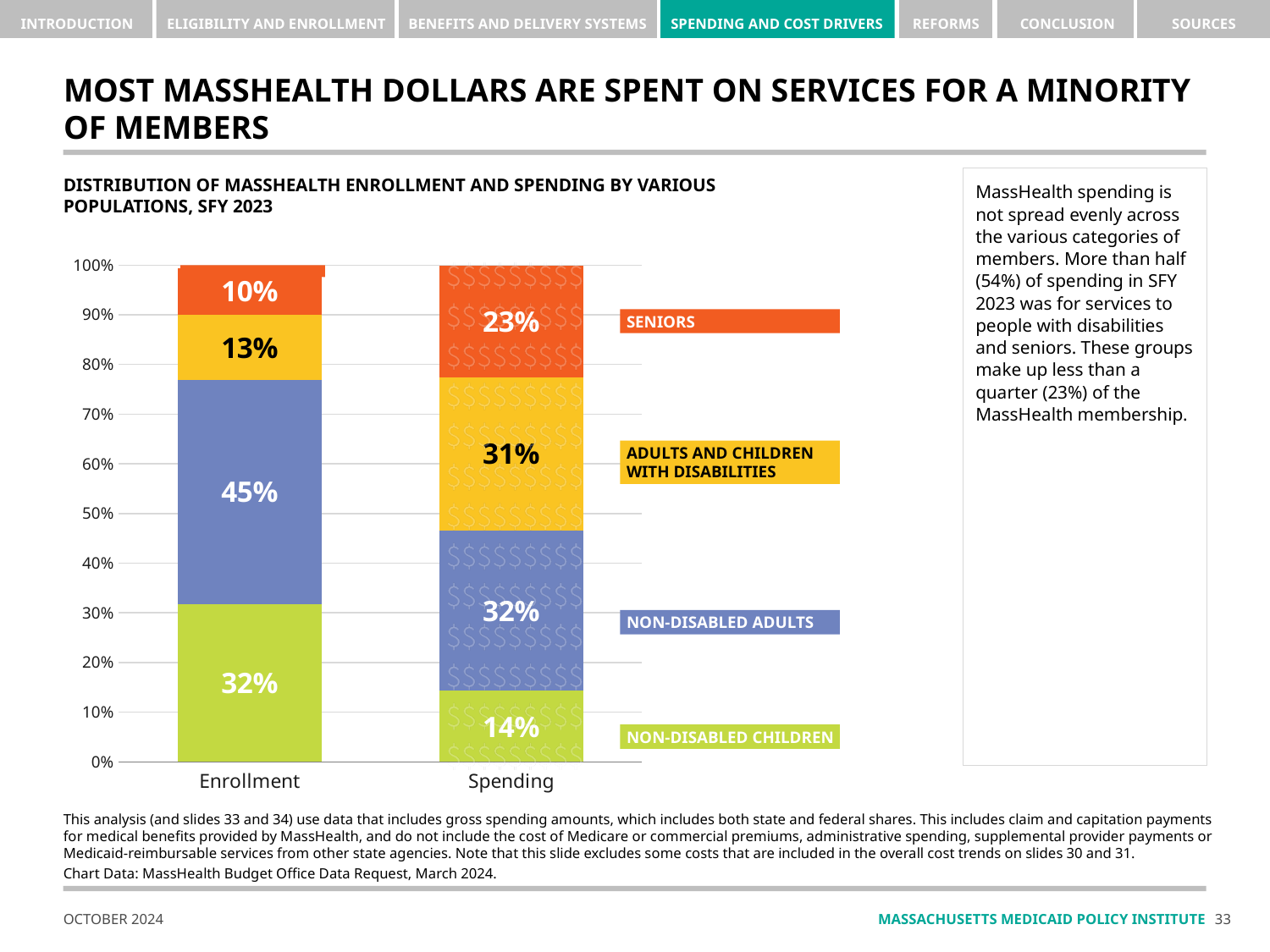
Is the Non-Disabled Children share larger in Enrollment or in Spending? Enrollment What share of Spending goes to Seniors? 23% Which population group has the smallest share of Spending? Non-Disabled Children What share of Enrollment is made up of Non-Disabled Adults? 45% What type of chart is shown on the slide? Stacked bar chart Which population group has the largest share of Enrollment? Non-Disabled Adults What share of Enrollment is made up of Seniors? 10% How many population groups are listed in the chart's legend? 4 How many bars are shown on the x axis of the chart? 2 What is the difference between the Seniors share of Spending and the Seniors share of Enrollment? 13 percentage points What colour represents Seniors in the chart? Orange What share of Spending goes to Adults and Children with Disabilities? 31%